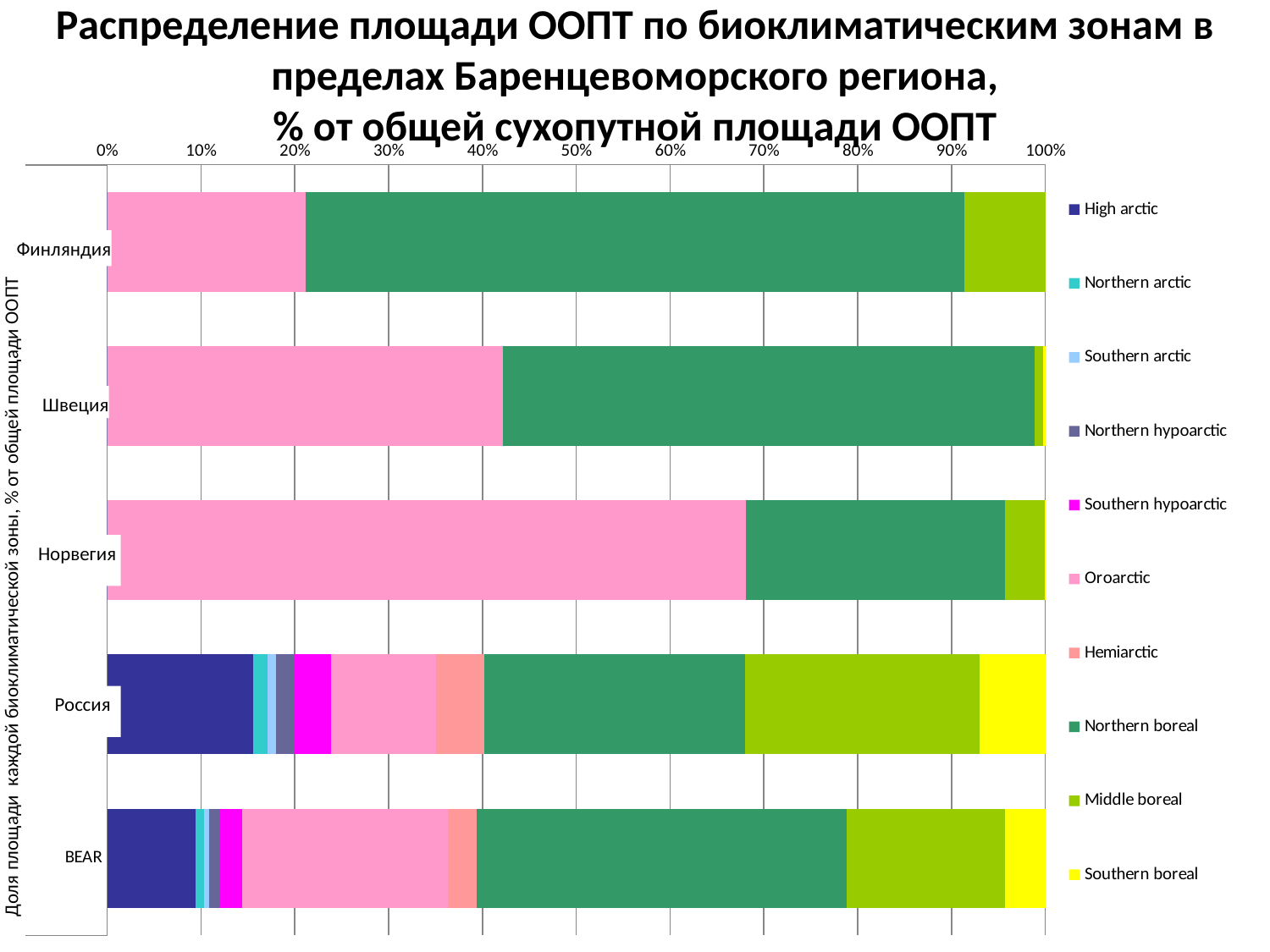
Is the Oroarctic share for Норвегия greater or less than 60%? greater How many categories (countries/regions) are plotted on the vertical axis? 5 Is the Oroarctic share for Финляндия greater or less than 30%? less Is the High arctic share for Россия greater or less than 10%? greater Which has the larger Oroarctic share, Норвегия or Финляндия? Норвегия What kind of chart is shown on the slide? Stacked bar chart Which series is listed last in the legend? Southern boreal How many series does the legend list? 10 Which series is listed first in the legend? High arctic Which has the larger Northern boreal share, Финляндия or Россия? Финляндия Which category has the largest Oroarctic segment? Норвегия